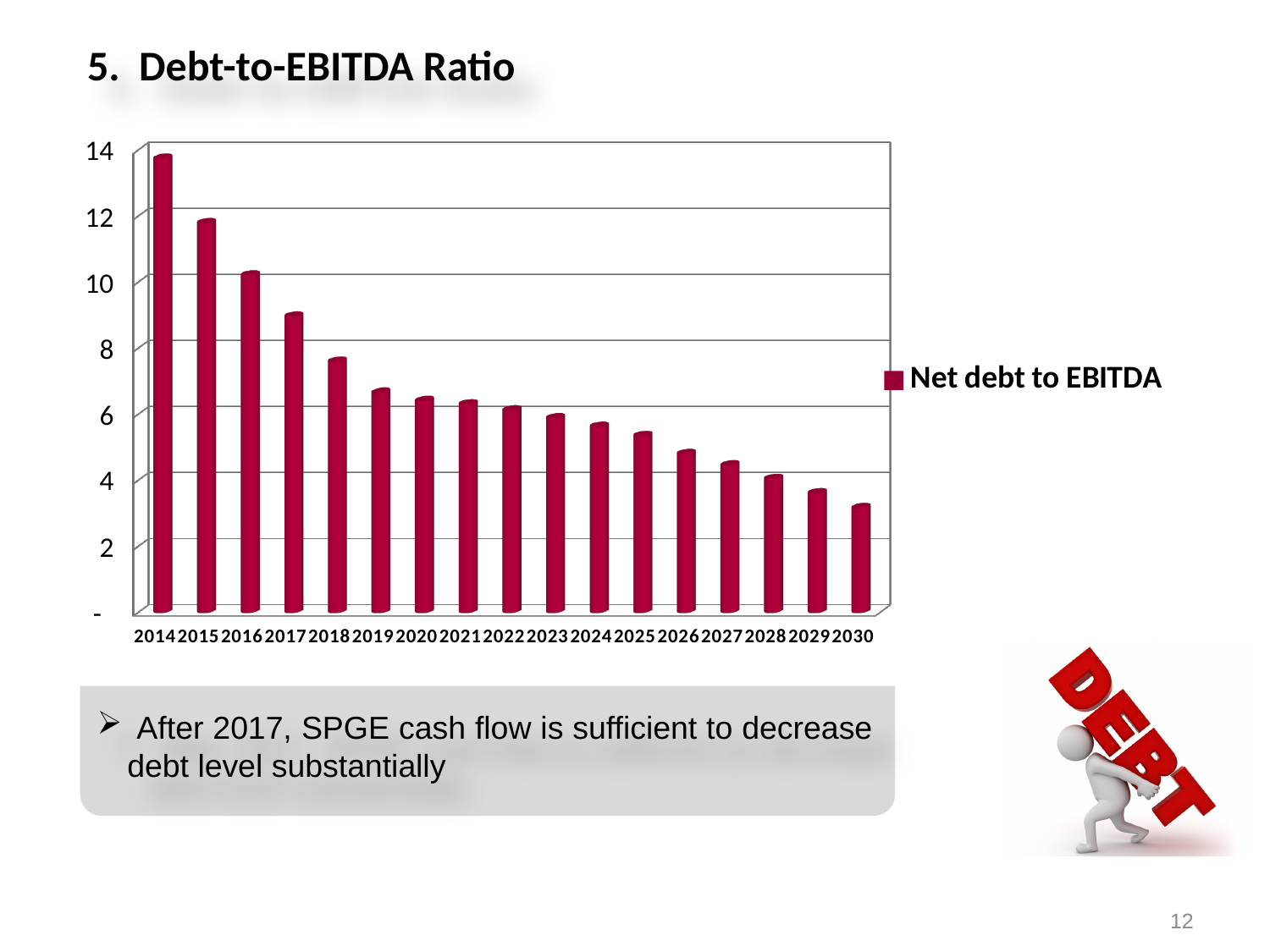
Do the Net debt to EBITDA values rise or fall from 2014 to 2030? Fall Is the Net debt to EBITDA value for 2025 greater or less than 4? greater What kind of chart is shown on the slide? Bar chart Is the Net debt to EBITDA value for 2017 greater or less than 8? greater Is the Net debt to EBITDA value for 2030 greater or less than 4? less What is the name of the series shown in the chart legend? Net debt to EBITDA Which year has the lowest Net debt to EBITDA value? 2030 How many years are plotted on the x axis of the chart? 17 Which year has the highest Net debt to EBITDA value? 2014 How many series does the chart legend list? 1 Which year has a larger Net debt to EBITDA value, 2017 or 2025? 2017